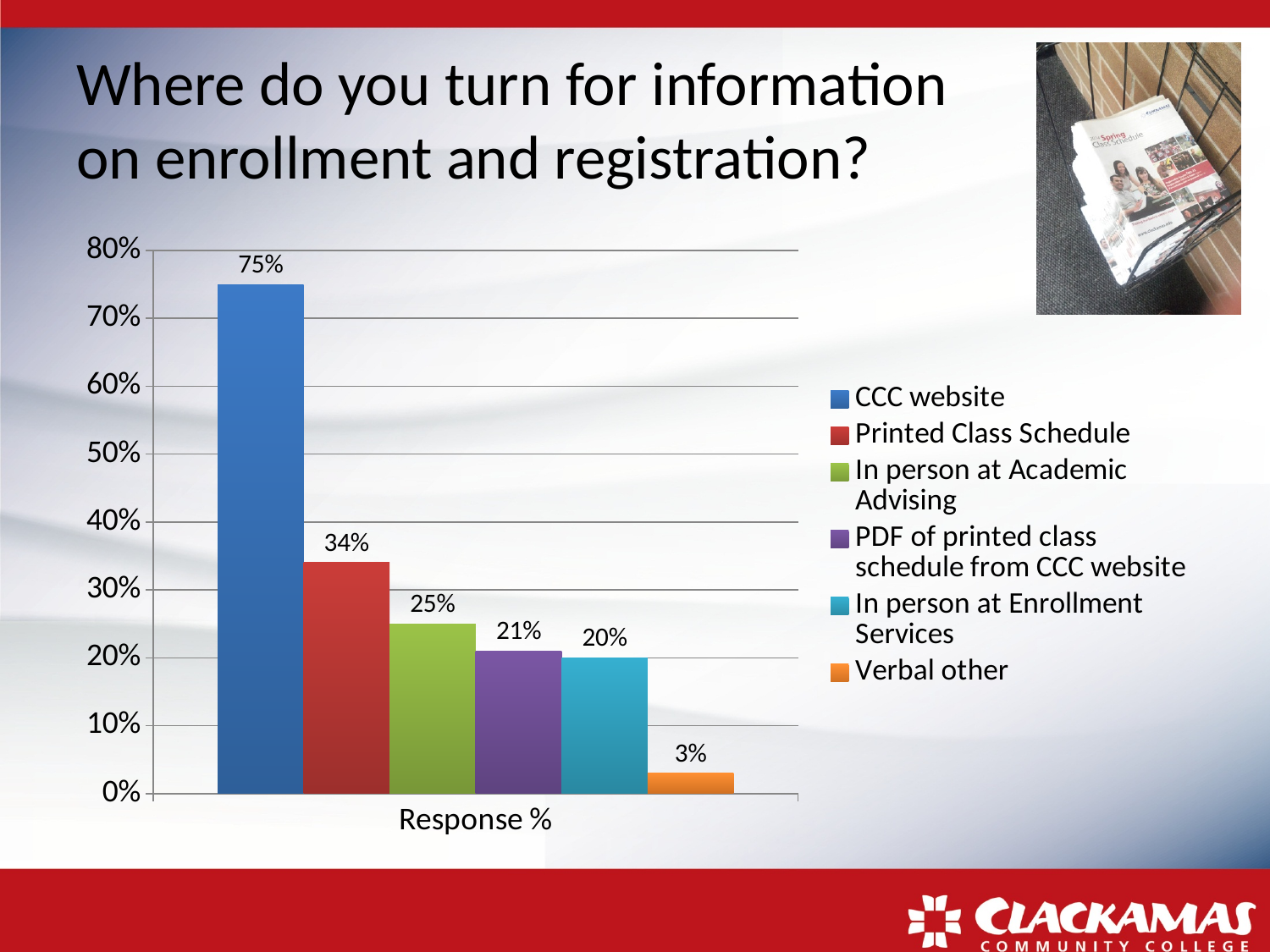
What is the value for Printed Class Schedule? 34% What kind of chart is shown on the slide? Bar chart What is the value for In person at Enrollment Services? 20% What is the value for Verbal other? 3% Which series has the highest value? CCC website What is the difference between the values for In person at Academic Advising and Verbal other? 22% Which series has the lowest value? Verbal other Which is larger, the value for Printed Class Schedule or the value for PDF of printed class schedule from CCC website? Printed Class Schedule What is the difference between the values for CCC website and Printed Class Schedule? 41% How many series does the legend list? 6 What is the value for CCC website? 75% What is the label on the x axis of the chart? Response %